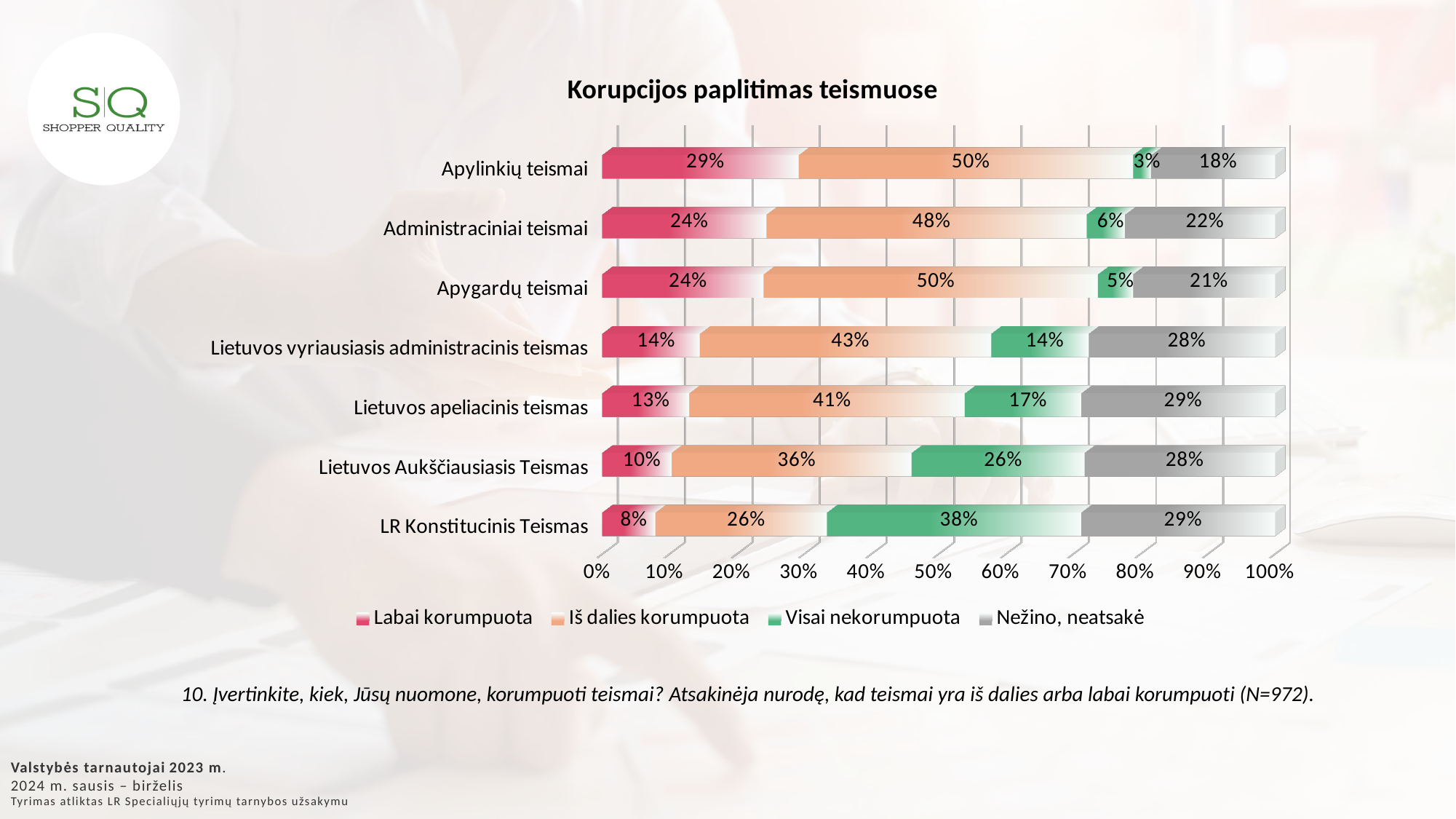
Which category has the highest 'Labai korumpuota' value? Apylinkių teismai What is the 'Nežino, neatsakė' value for Lietuvos apeliacinis teismas? 29% How many series does the legend list? 4 What is the 'Labai korumpuota' value for Apylinkių teismai? 29% What is the difference between the 'Iš dalies korumpuota' values for Apylinkių teismai and LR Konstitucinis Teismas? 24% What is the 'Iš dalies korumpuota' value for Lietuvos Aukščiausiasis Teismas? 36% What kind of chart is shown on the slide? Stacked bar chart How many categories (courts) are shown on the chart? 7 What is the 'Visai nekorumpuota' value for LR Konstitucinis Teismas? 38% Which is larger: the 'Visai nekorumpuota' value for Lietuvos Aukščiausiasis Teismas or for Lietuvos apeliacinis teismas? Lietuvos Aukščiausiasis Teismas Which category has the lowest 'Visai nekorumpuota' value? Apylinkių teismai What is the title of the chart? Korupcijos paplitimas teismuose